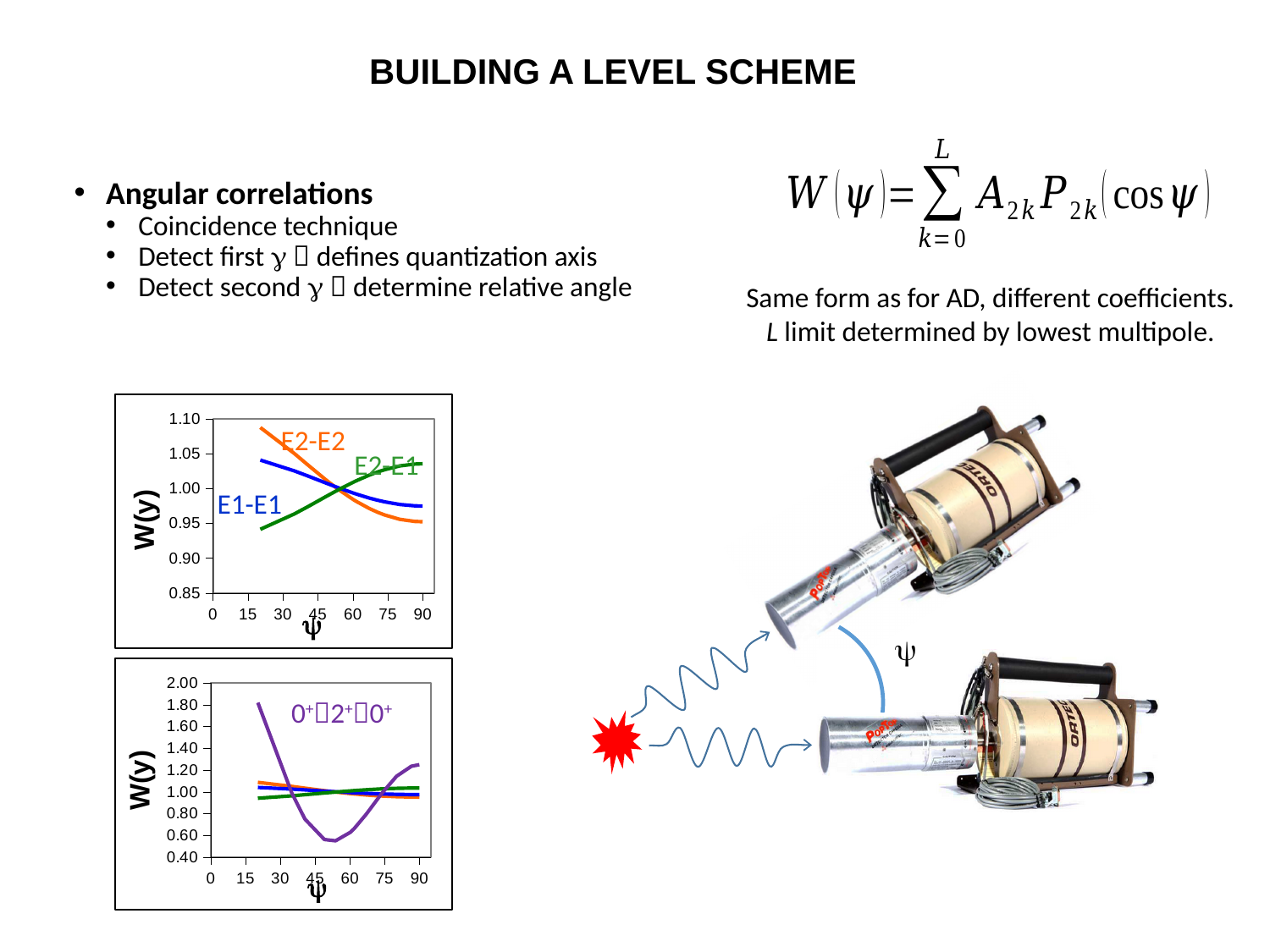
In the top chart, does the E2-E2 curve rise or fall as ψ increases from 20 to 90? fall How many curves are plotted in the bottom chart? 4 In the bottom chart, is the minimum value of the 0+→2+→0+ curve greater or less than 0.80? less What is the label on the y axis of the top chart? W(y) In the top chart, does the E1-E1 curve rise or fall as ψ increases? fall In the top chart, is the value of the E2-E1 curve at ψ = 20 greater or less than 1.00? less What kind of chart is the top chart on the left of the slide? line chart In the top chart, is the value of the E2-E2 curve at ψ = 20 greater or less than 1.05? greater In the top chart, which curve has the highest value at ψ = 20? E2-E2 In the top chart, does the E2-E1 curve rise or fall as ψ increases? rise In the top chart, at ψ = 90, which curve is larger, E2-E1 or E2-E2? E2-E1